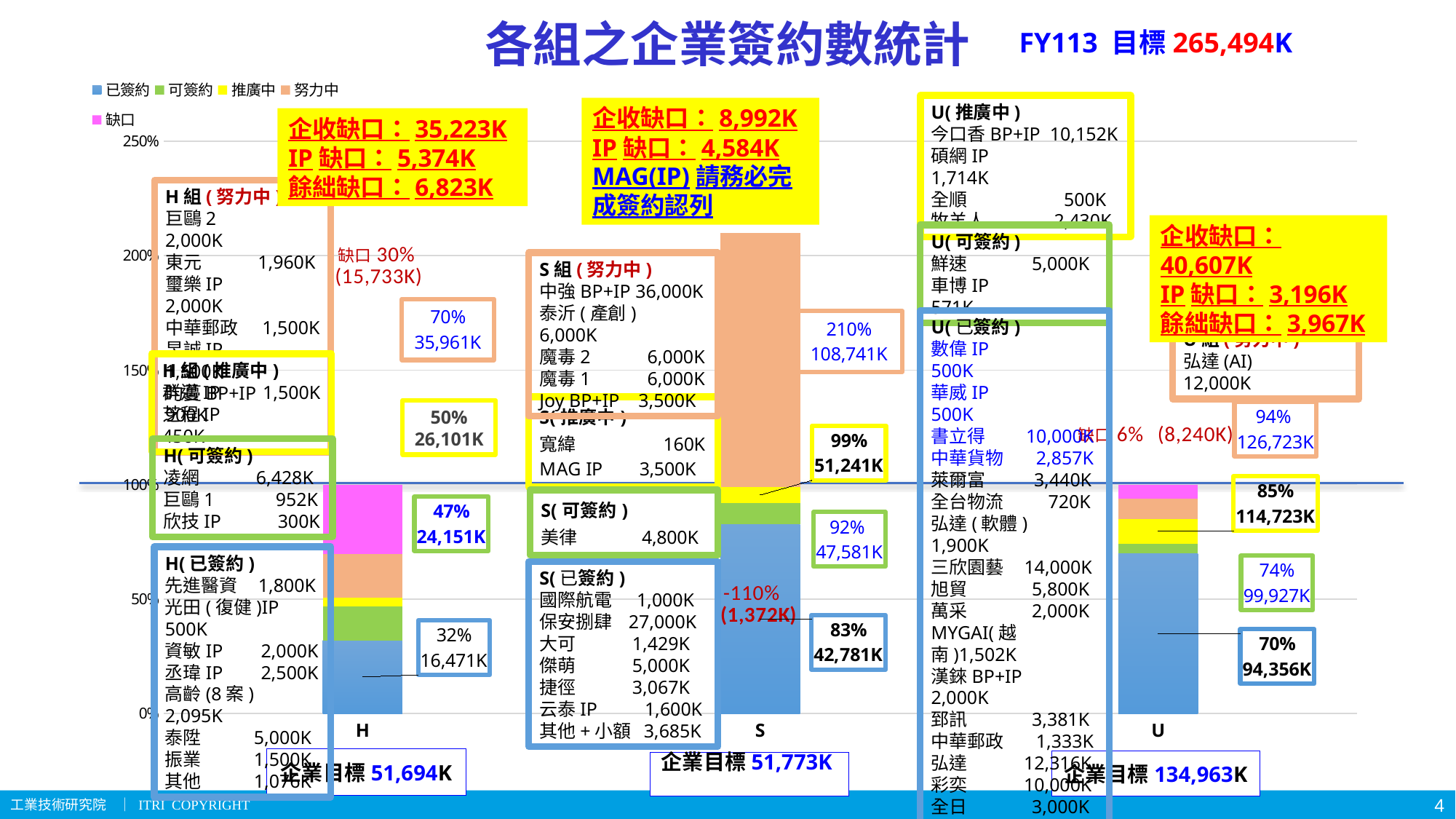
What percentage and value are labelled for the 已簽約 (signed) segment of group H? 32%, 16,471K How many series does the chart legend list? 5 What is the 企業目標 (enterprise target) shown for group U? 134,963K What is the 缺口 (gap) labelled for group U? 6% (8,240K) What percentage and value are labelled for the 已簽約 (signed) segment of group S? 83%, 42,781K How many groups (categories) are shown on the x axis of the chart? 3 Which group's 已簽約 (signed) percentage is larger, H at 32% or U at 70%? U What kind of chart is shown on the slide? stacked bar chart What is the 缺口 (gap) labelled for group H? 30% (15,733K) Which group has the highest 企業目標 (enterprise target)? U What is the FY113 目標 (target) shown at the top of the slide? 265,494K What is the 企業目標 (enterprise target) shown for group H? 51,694K